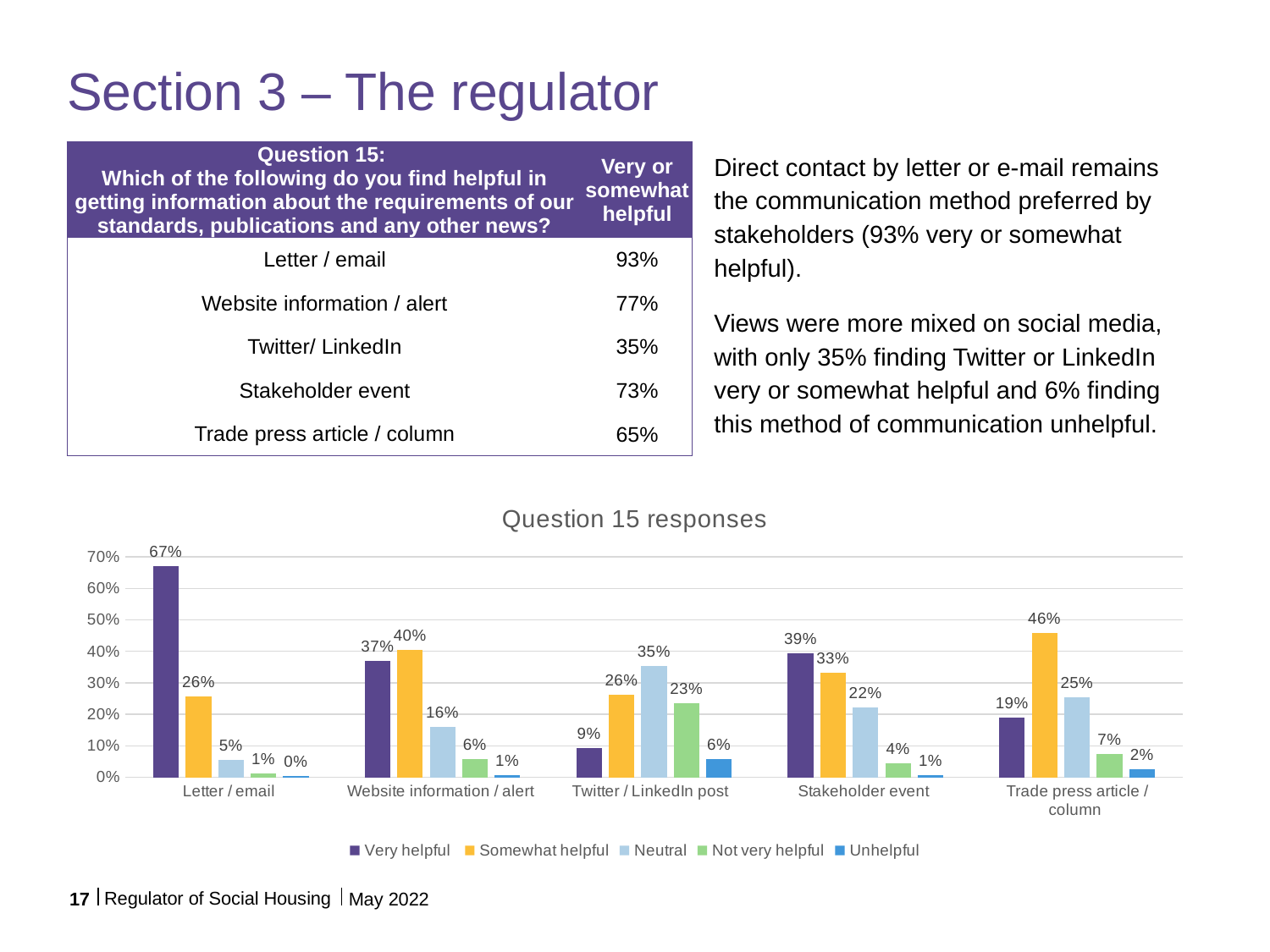
What is the difference between the 'Somewhat helpful' values for Trade press article / column and Letter / email? 20% What is the 'Very helpful' value for Letter / email? 67% Which is larger for Stakeholder event: the 'Very helpful' value or the 'Somewhat helpful' value? Very helpful What is the 'Somewhat helpful' value for Trade press article / column? 46% What is the 'Neutral' value for Twitter / LinkedIn post? 35% What is the 'Unhelpful' value for Letter / email? 0% Which category has the highest 'Very helpful' value? Letter / email How many series does the chart legend list? 5 What is the title of the chart? Question 15 responses What kind of chart is shown on the slide? bar chart Which category has the lowest 'Very helpful' value? Twitter / LinkedIn post How many categories are shown on the x axis of the chart? 5